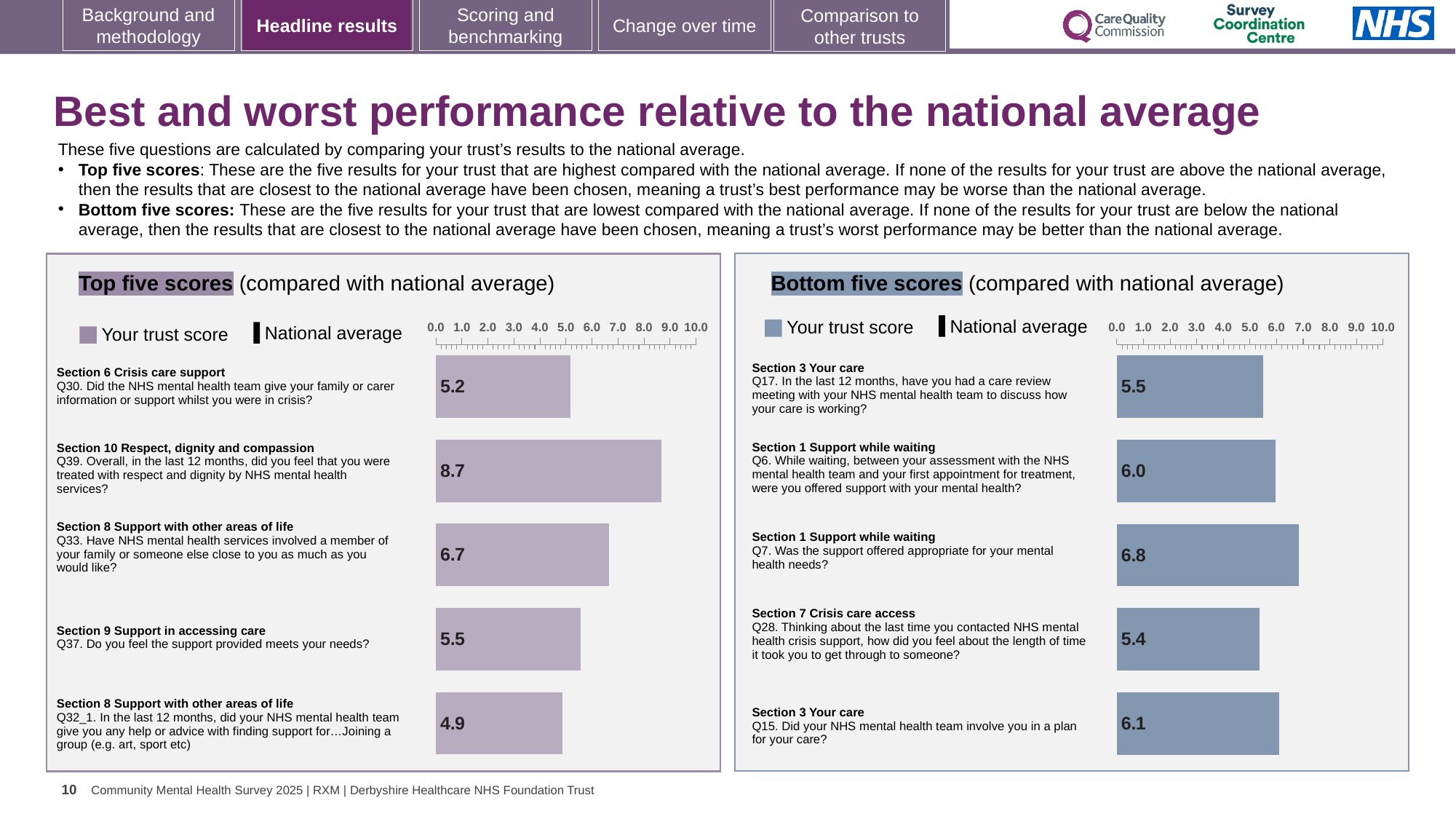
What type of chart is used for the Top five scores? Bar chart In the Top five scores chart, what is the trust score for Q39 (treated with respect and dignity)? 8.7 In the Bottom five scores chart, which question has the lowest trust score? Q28 In the Bottom five scores chart, what is the trust score for Q28 (length of time to get through to crisis support)? 5.4 What is the maximum value shown on the axis of the Bottom five scores chart? 10.0 How many questions are plotted in the Bottom five scores chart? 5 In the Top five scores chart, what is the difference between the trust scores for Q39 and Q30? 3.5 In the Top five scores chart, which question has the highest trust score? Q39 In the Bottom five scores chart, what is the trust score for Q7 (was the support offered appropriate)? 6.8 In the Top five scores chart, what is the trust score for Q32_1 (help finding support for joining a group)? 4.9 In the Bottom five scores chart, which has the larger trust score, Q6 or Q15? Q15 In the Top five scores chart, is the trust score for Q33 greater or less than 6.0? greater